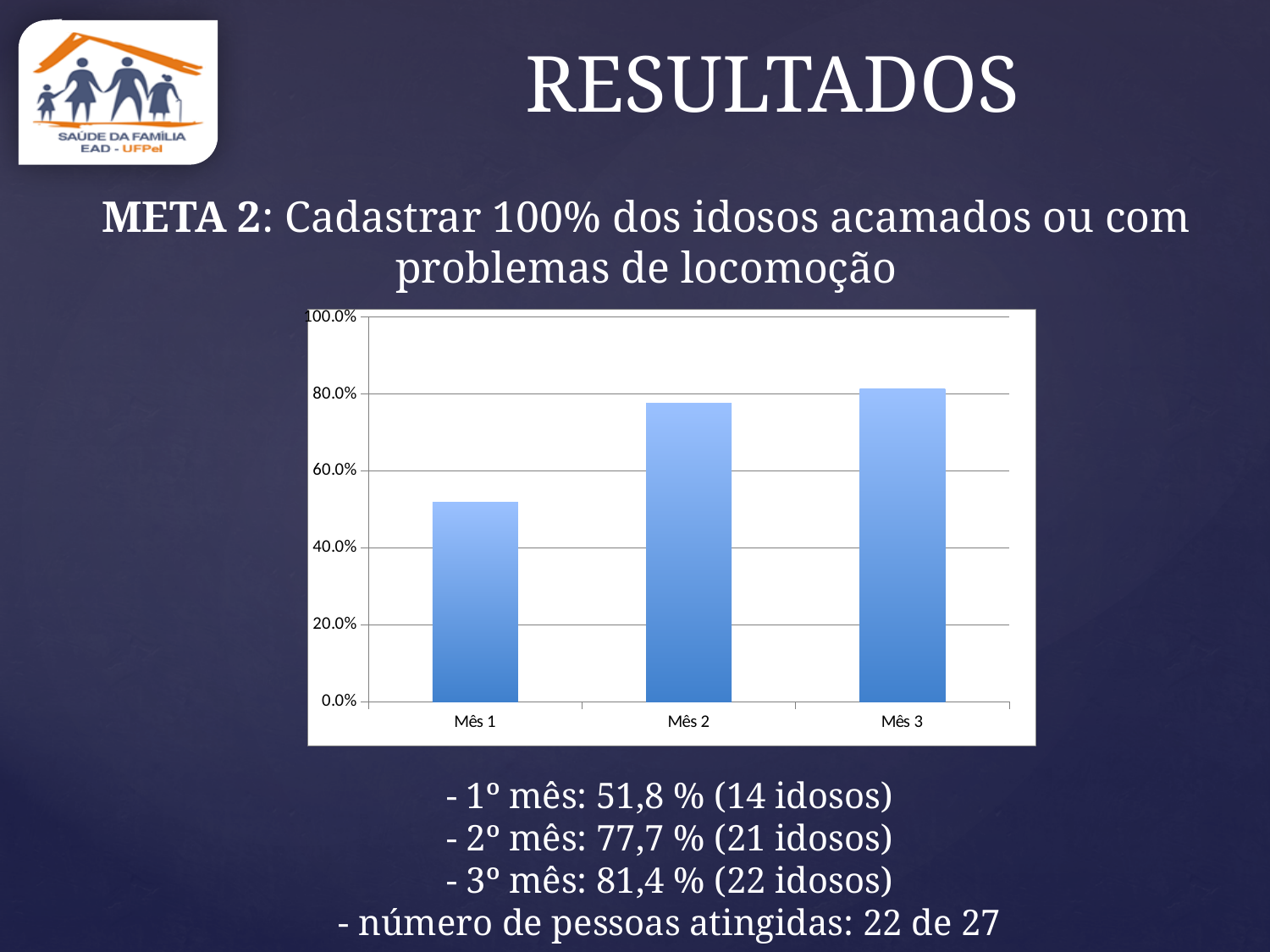
Is the value for Mês 2 greater or less than 60.0%? greater Is the value for Mês 1 greater or less than 60.0%? less Do the values rise or fall from Mês 1 to Mês 3? rise According to the text below the chart, what percentage was reached in the 3º mês? 81,4 % Which month has the highest bar in the chart? Mês 3 Is the value for Mês 1 greater or less than 40.0%? greater Which is larger, the value for Mês 1 or the value for Mês 2? Mês 2 According to the text below the chart, what percentage was reached in the 1º mês? 51,8 % What kind of chart is shown on the slide? bar chart Which month has the lowest bar in the chart? Mês 1 How many categories (months) are plotted in the chart? 3